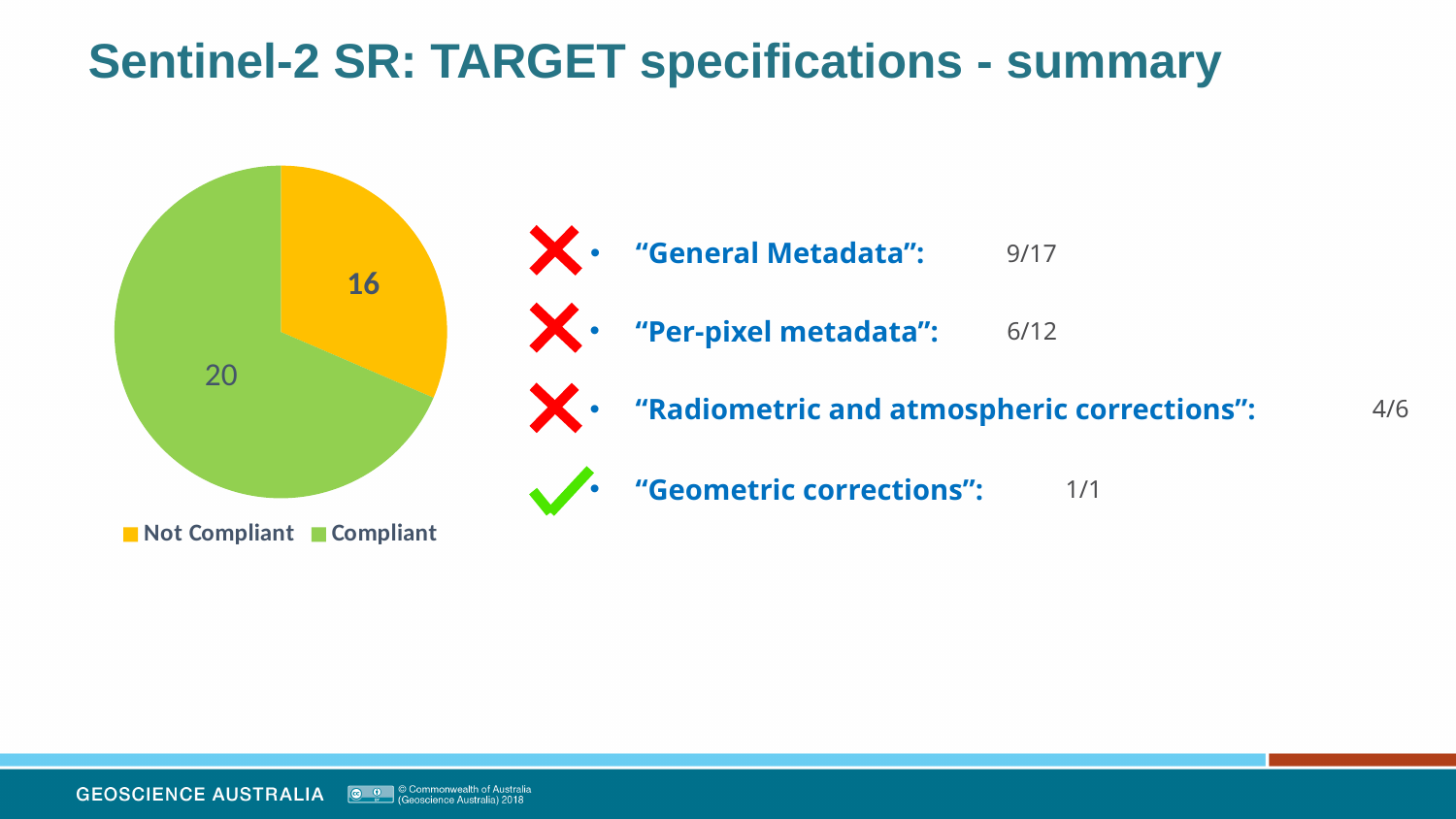
What is the total of the two slices in the pie chart? 36 What colour is the Not Compliant slice in the pie chart? orange What fraction of the pie chart total does the Compliant slice represent? 20 of 36 What is the value for the Compliant slice of the pie chart? 20 Which is larger in the pie chart, Compliant or Not Compliant? Compliant What type of chart is shown on the slide? pie chart What is the value for the Not Compliant slice of the pie chart? 16 Which slice of the pie chart is the largest? Compliant Which slice of the pie chart is the smallest? Not Compliant What is the difference between the Compliant and Not Compliant values in the pie chart? 4 How many slices does the pie chart have? 2 How many entries does the pie chart legend list? 2